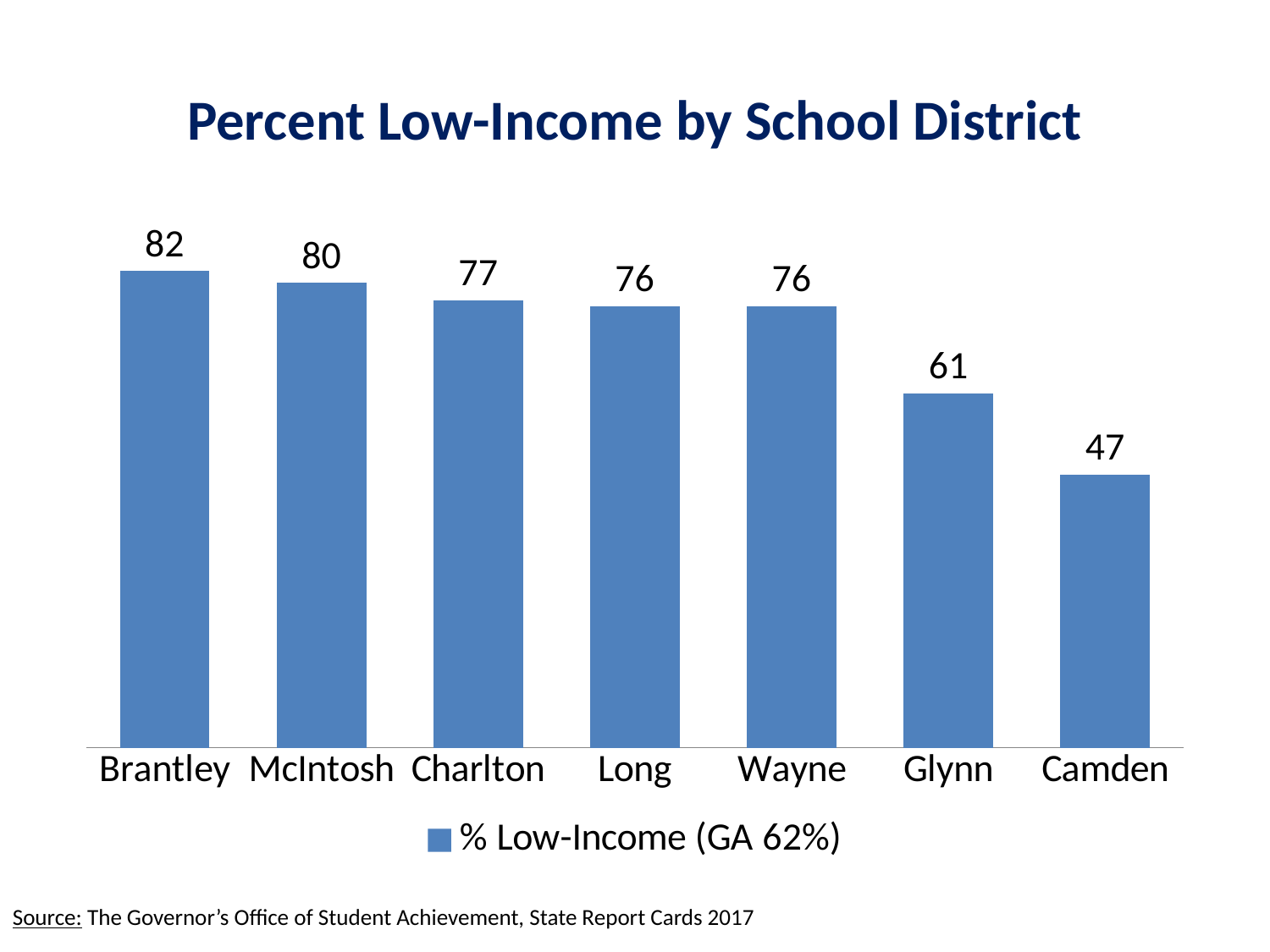
What is the percent low-income value for Brantley? 82 What is the percent low-income value for Glynn? 61 What is the percent low-income value for Camden? 47 Which has a higher percent low-income, Charlton or Glynn? Charlton Which school district has the lowest percent low-income? Camden What kind of chart is shown on the slide? Bar chart How many series does the legend list? 1 How many school districts are shown in the chart? 7 What is the difference between the values for Brantley and Camden? 35 Which school district has the highest percent low-income? Brantley What is the title of the chart? Percent Low-Income by School District What is the difference between the values for McIntosh and Glynn? 19